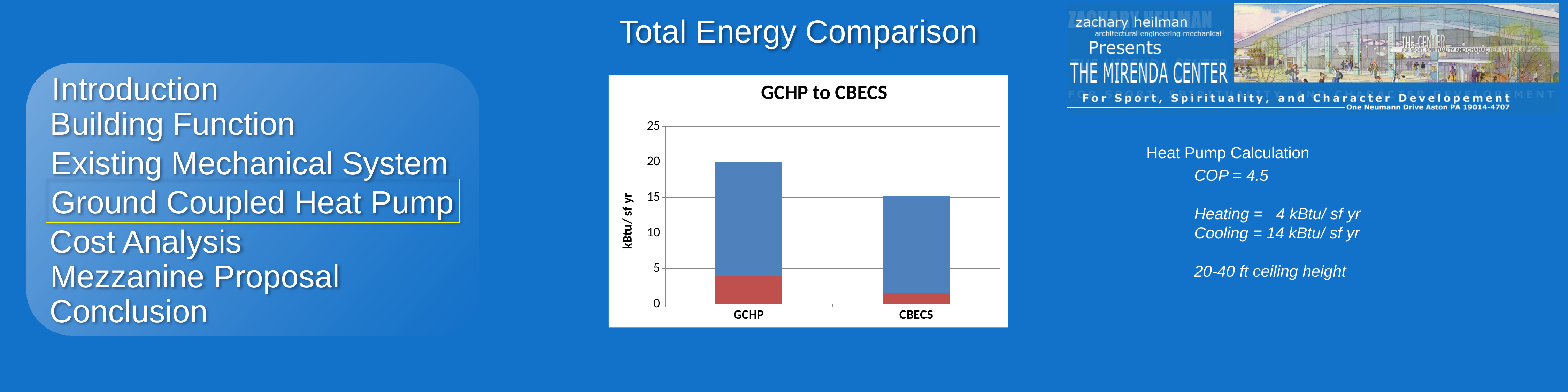
What kind of chart is shown on the slide? bar chart Is the total value for CBECS greater or less than 10? greater Is the red (bottom) segment of the CBECS bar greater or less than 5? less What is the title of the chart on the slide? GCHP to CBECS What is the total height of the GCHP bar in kBtu/ sf yr? 20 Is the red (bottom) segment of the GCHP bar greater or less than 5? less Is the total bar for GCHP larger or smaller than the total bar for CBECS? larger What is the label of the vertical axis of the chart? kBtu/ sf yr Which category has the taller total bar, GCHP or CBECS? GCHP Which category has the shorter total bar in the chart? CBECS How many categories are shown on the x axis of the chart? 2